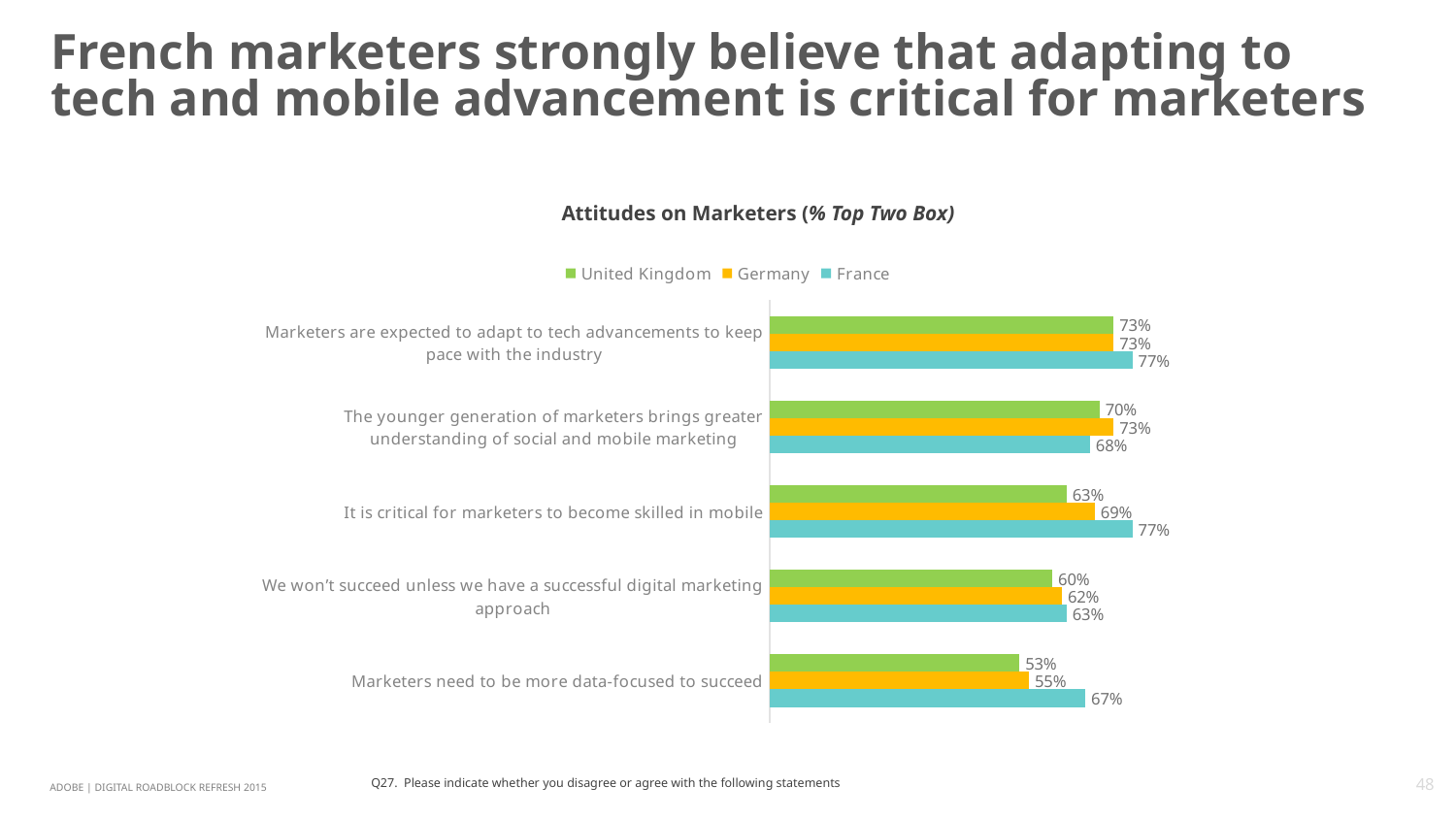
What is the difference between France and the United Kingdom on 'Marketers need to be more data-focused to succeed'? 14% Which country has the lowest value for 'Marketers need to be more data-focused to succeed'? United Kingdom How many statements (categories) are shown in the chart? 5 How many series does the legend list? 3 What is the title of the chart? Attitudes on Marketers (% Top Two Box) What kind of chart is shown on the slide? Bar chart What is the value for France on 'It is critical for marketers to become skilled in mobile'? 77% What is the value for the United Kingdom on 'Marketers need to be more data-focused to succeed'? 53% What is the difference between France and the United Kingdom on 'It is critical for marketers to become skilled in mobile'? 14% Which country has the highest value for 'It is critical for marketers to become skilled in mobile'? France Is the value for Germany or France larger on 'The younger generation of marketers brings greater understanding of social and mobile marketing'? Germany What is the value for Germany on 'The younger generation of marketers brings greater understanding of social and mobile marketing'? 73%